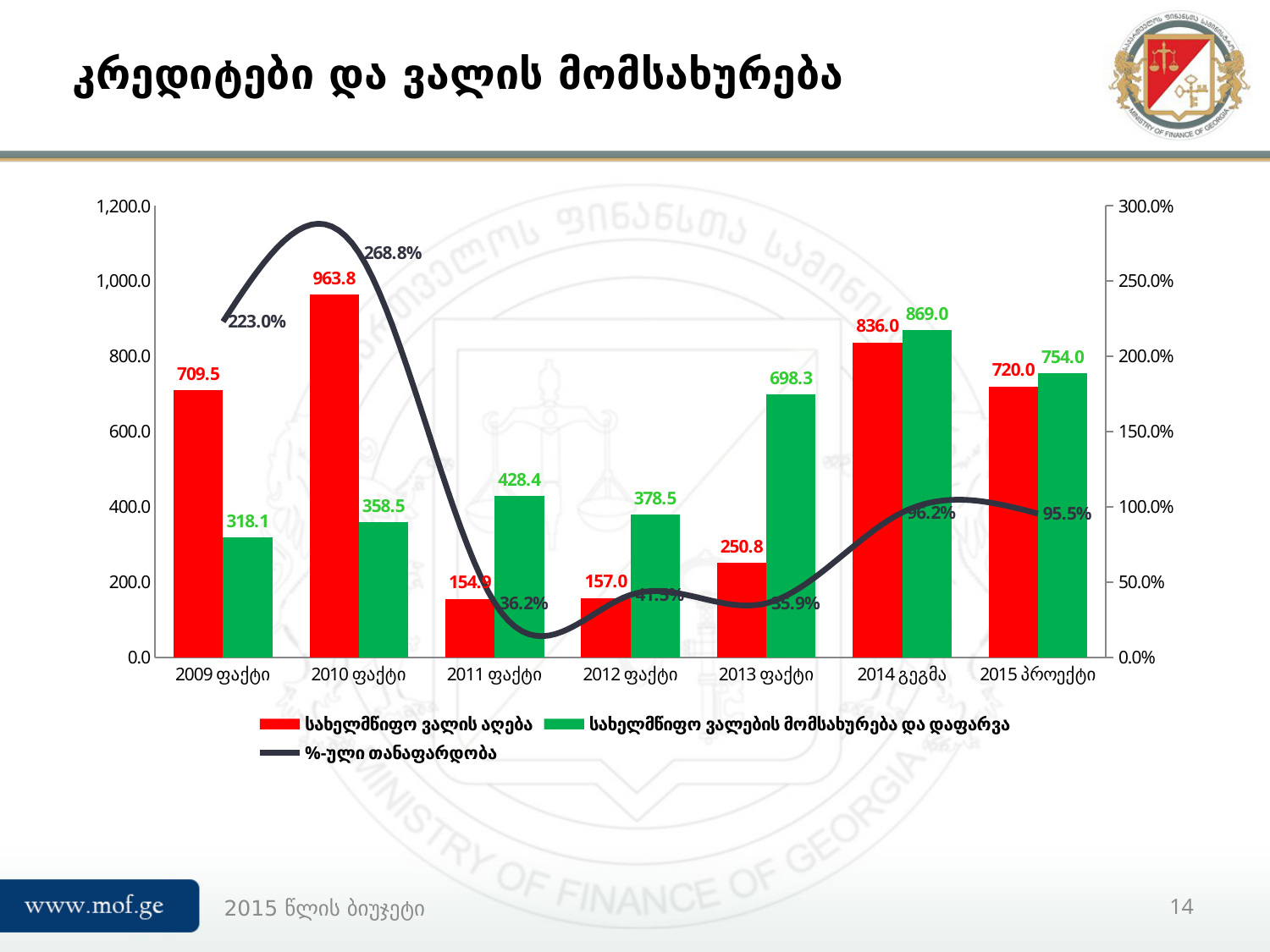
What is the value of the green series (სახელმწიფო ვალების მომსახურება და დაფარვა) for 2013 ფაქტი? 698.3 Which category has the highest value for the red series (სახელმწიფო ვალის აღება)? 2010 ფაქტი Which category has the lowest value for the green series (სახელმწიფო ვალების მომსახურება და დაფარვა)? 2009 ფაქტი What is the value of the red series (სახელმწიფო ვალის აღება) for 2010 ფაქტი? 963.8 How many categories are shown on the x axis? 7 Is the red series value for 2013 ფაქტი greater or less than 400.0? less For 2009 ფაქტი, which is larger: the red series or the green series? the red series (709.5) What is the value of the line series (%-ული თანაფარდობა) for 2010 ფაქტი? 268.8% What kind of chart is shown on the slide? a combined bar and line chart How many series does the legend list? 3 What is the difference between the green and red values for 2014 გეგმა? 33.0 What is the value of the green series for 2015 პროექტი? 754.0